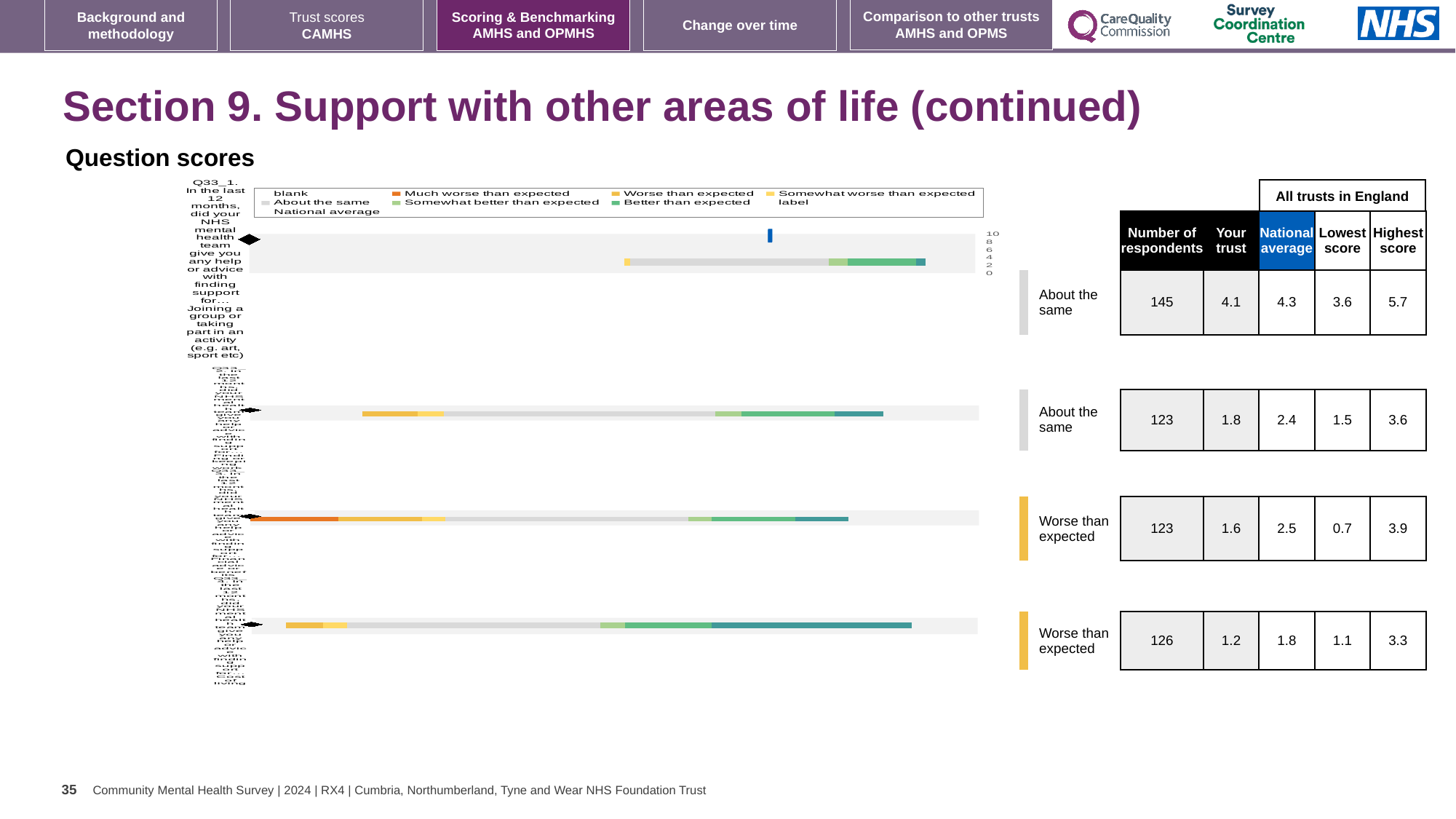
Which question row has the highest number of respondents in the table? Q33_1 (joining a group or taking part in an activity), 145 What is the 'Your trust' score for Q33_1 (joining a group or taking part in an activity)? 4.1 In the table next to the chart, what is the number of respondents for Q33_1 (help finding support for joining a group or taking part in an activity)? 145 What is the lowest score across all trusts in England for the third question row? 0.7 How many of the question rows are labelled 'Worse than expected'? 2 What is the highest score across all trusts in England for the bottom (fourth) question row? 3.3 For Q33_1 (joining a group or taking part in an activity), what is the difference between the national average and the 'Your trust' score? 0.2 What is the national average score for Q33_1 (joining a group or taking part in an activity)? 4.3 How many question rows (bars) are plotted in the question scores chart? 4 What kind of chart is used to show the question scores on this slide? bar chart What colour does the legend use for 'Much worse than expected'? Orange For Q33_1 (joining a group or taking part in an activity), which is higher: the 'Your trust' score or the national average? National average